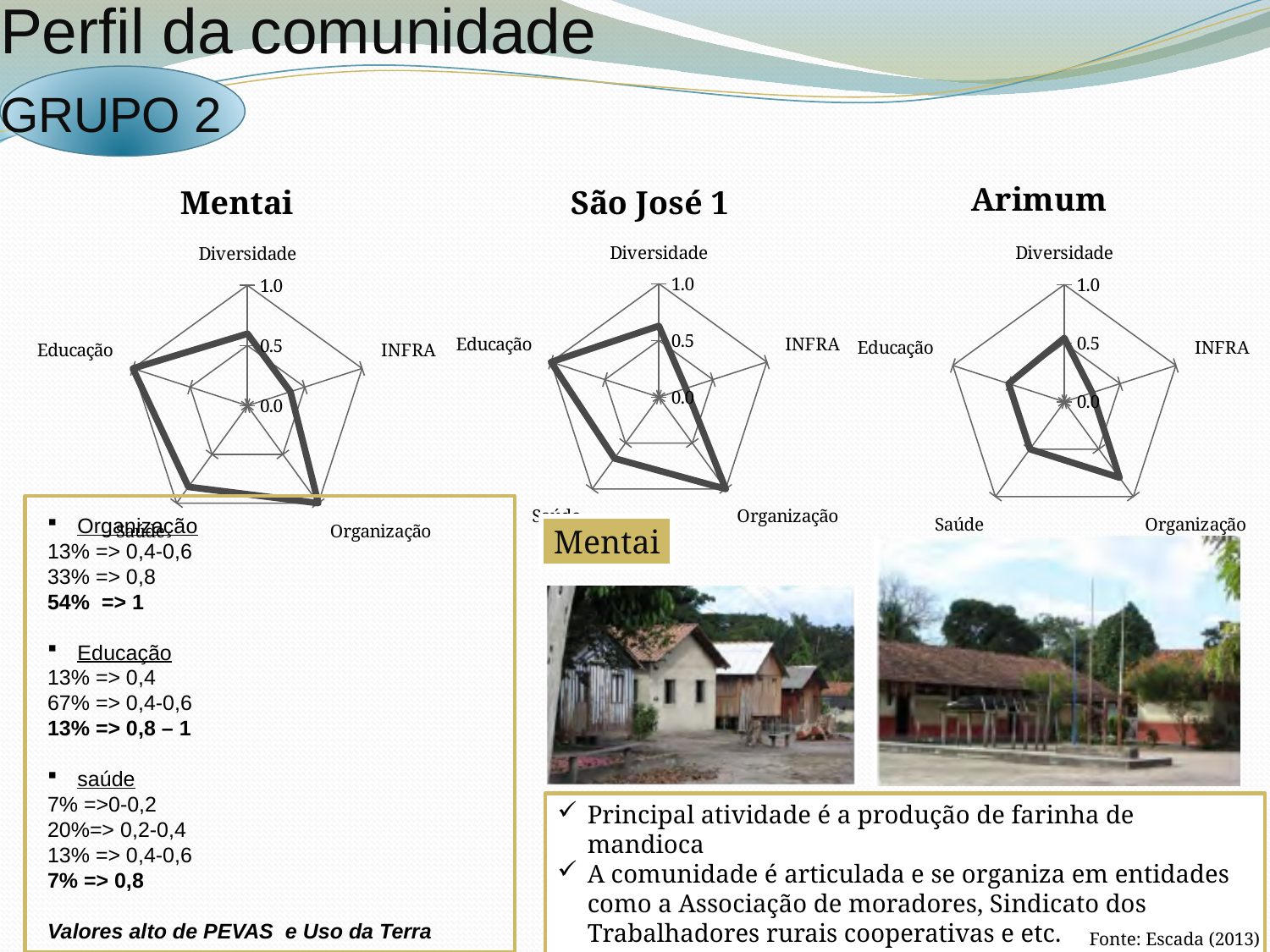
In the Mentai chart, is the value for INFRA greater or less than 0.5? less What are the three community names given as chart titles on the slide? Mentai, São José 1, Arimum In the Arimum chart, is the value for INFRA greater or less than 0.5? less In the Arimum chart, is the value for Organização greater or less than 0.5? greater How many axes (categories) does the São José 1 radar chart have? 5 What kind of chart is used for the Mentai community profile? Radar chart In the São José 1 chart, which category has the lowest value? INFRA What is the maximum value shown on the axis scale of the Arimum radar chart? 1.0 In the Mentai chart, which is larger, the value for Educação or the value for INFRA? Educação